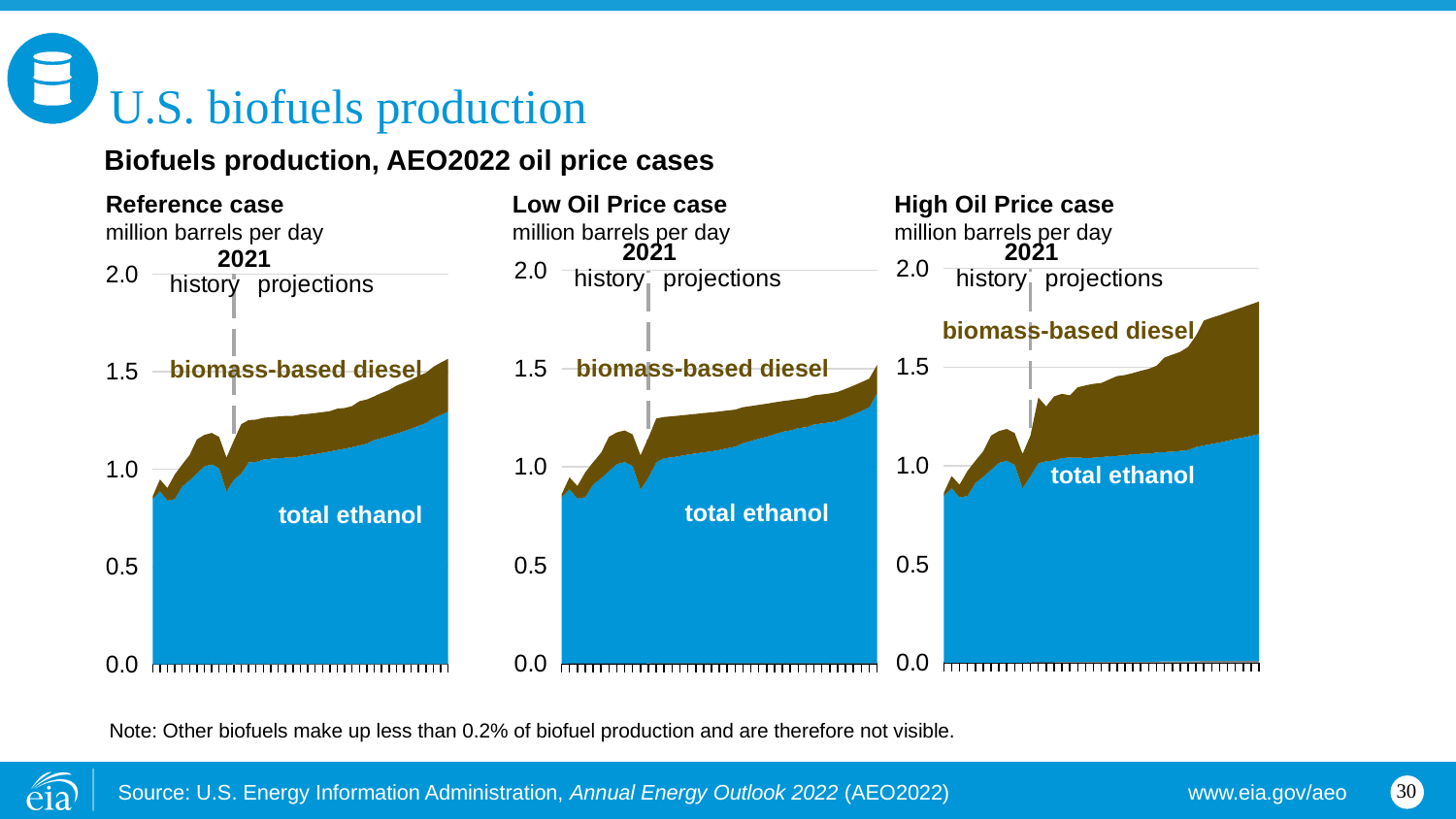
Which case shows the highest total biofuels production at the end of the projection period: the Low Oil Price case or the High Oil Price case? High Oil Price case In the Reference case chart, is total ethanol production at the start of the history period greater or less than 1.0 million barrels per day? less How many charts are shown on the slide? 3 How many series are plotted in the Low Oil Price case chart? 2 What kind of chart is the Reference case chart? stacked area chart What unit is used on the y axis of the Reference case chart? million barrels per day In the High Oil Price case chart, does total biofuels production rise or fall over the projection period? rise In the Low Oil Price case chart, is total biofuels production at the end of the projection period greater or less than 1.0 million barrels per day? greater In the High Oil Price case chart, is total ethanol production at the end of the projection period greater or less than 1.0 million barrels per day? greater In the Reference case chart, which series is larger at the end of the projection period, total ethanol or biomass-based diesel? total ethanol In the High Oil Price case chart, which series is plotted on top of total ethanol? biomass-based diesel